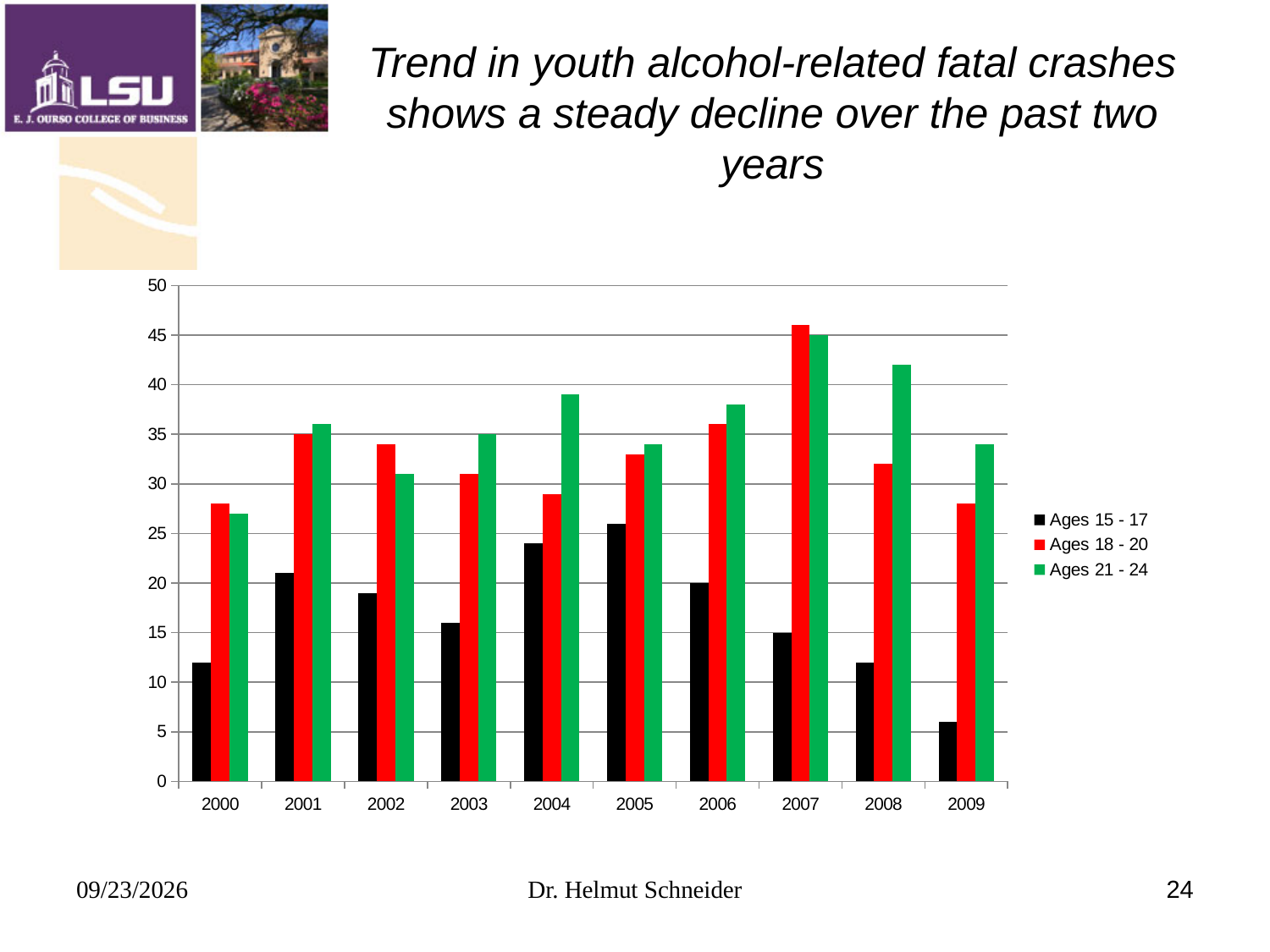
What type of chart is shown on the slide? Bar chart How many years are shown on the x axis? 10 In which year is the Ages 15 - 17 bar the lowest? 2009 In which year is the Ages 18 - 20 bar the highest? 2007 How many series does the legend list? 3 In which year is the Ages 21 - 24 bar the highest? 2007 In 2008, which series has the larger value, Ages 18 - 20 or Ages 21 - 24? Ages 21 - 24 Do the Ages 15 - 17 values rise or fall from 2007 to 2009? Fall Is the value for Ages 15 - 17 in 2009 greater or less than 10? less What colour represents the Ages 18 - 20 series in the legend? Red Is the value for Ages 21 - 24 in 2008 greater or less than 40? greater